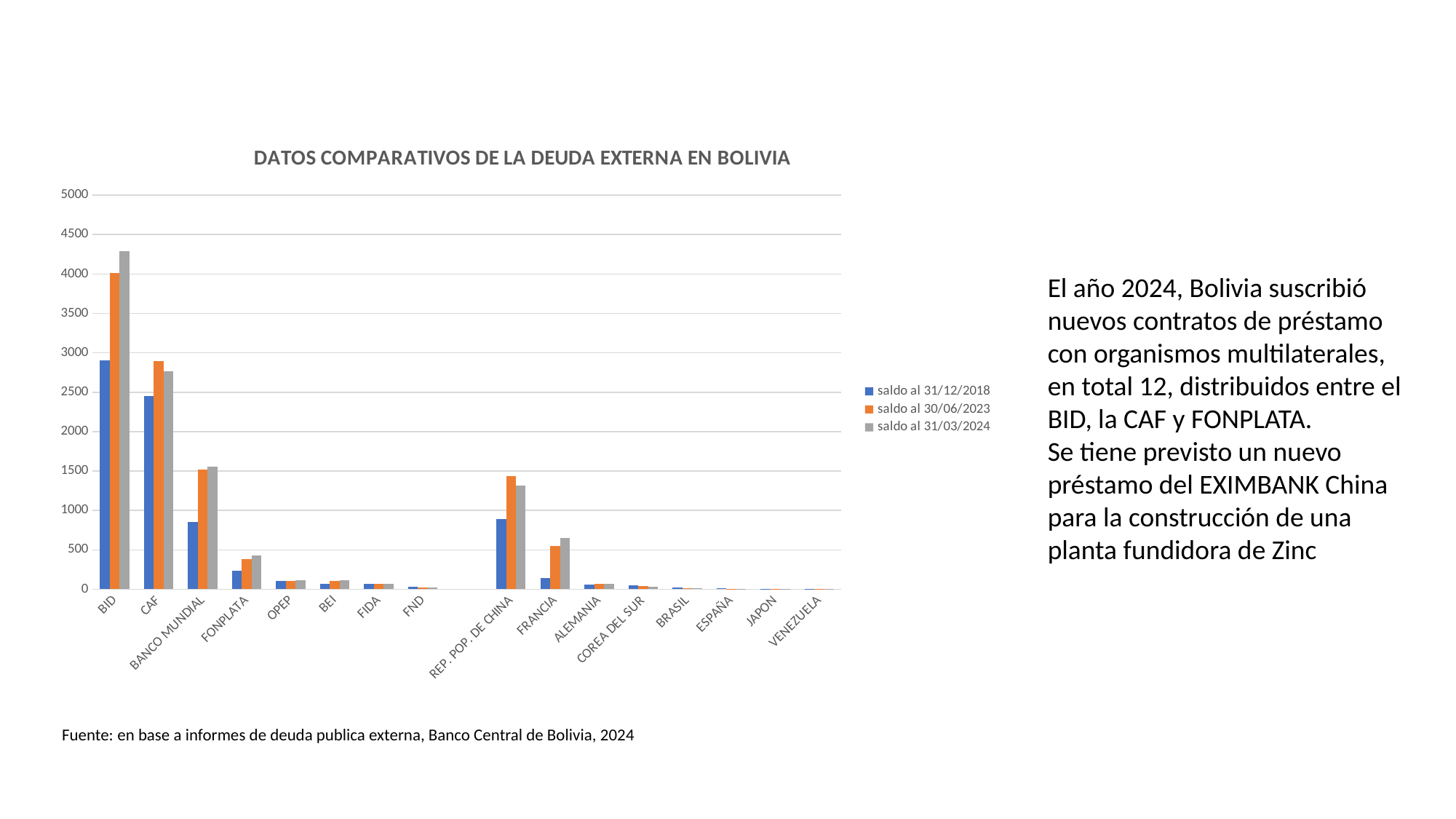
Which category has the highest value for the series 'saldo al 31/03/2024'? BID How many categories are shown on the x axis of the chart? 16 What kind of chart is shown on the slide? bar chart Is the value for CAF in the series 'saldo al 31/12/2018' greater or less than 3000? less Is the value for FRANCIA in the series 'saldo al 31/03/2024' greater or less than 500? greater How many series does the legend list? 3 For the series 'saldo al 30/06/2023', which is larger: BID or CAF? BID Is the value for BID in the series 'saldo al 31/03/2024' greater or less than 4000? greater What colour represents the series 'saldo al 30/06/2023' in the legend? orange What is the title of the chart? DATOS COMPARATIVOS DE LA DEUDA EXTERNA EN BOLIVIA For the series 'saldo al 31/03/2024', which is larger: BANCO MUNDIAL or REP. POP. DE CHINA? BANCO MUNDIAL